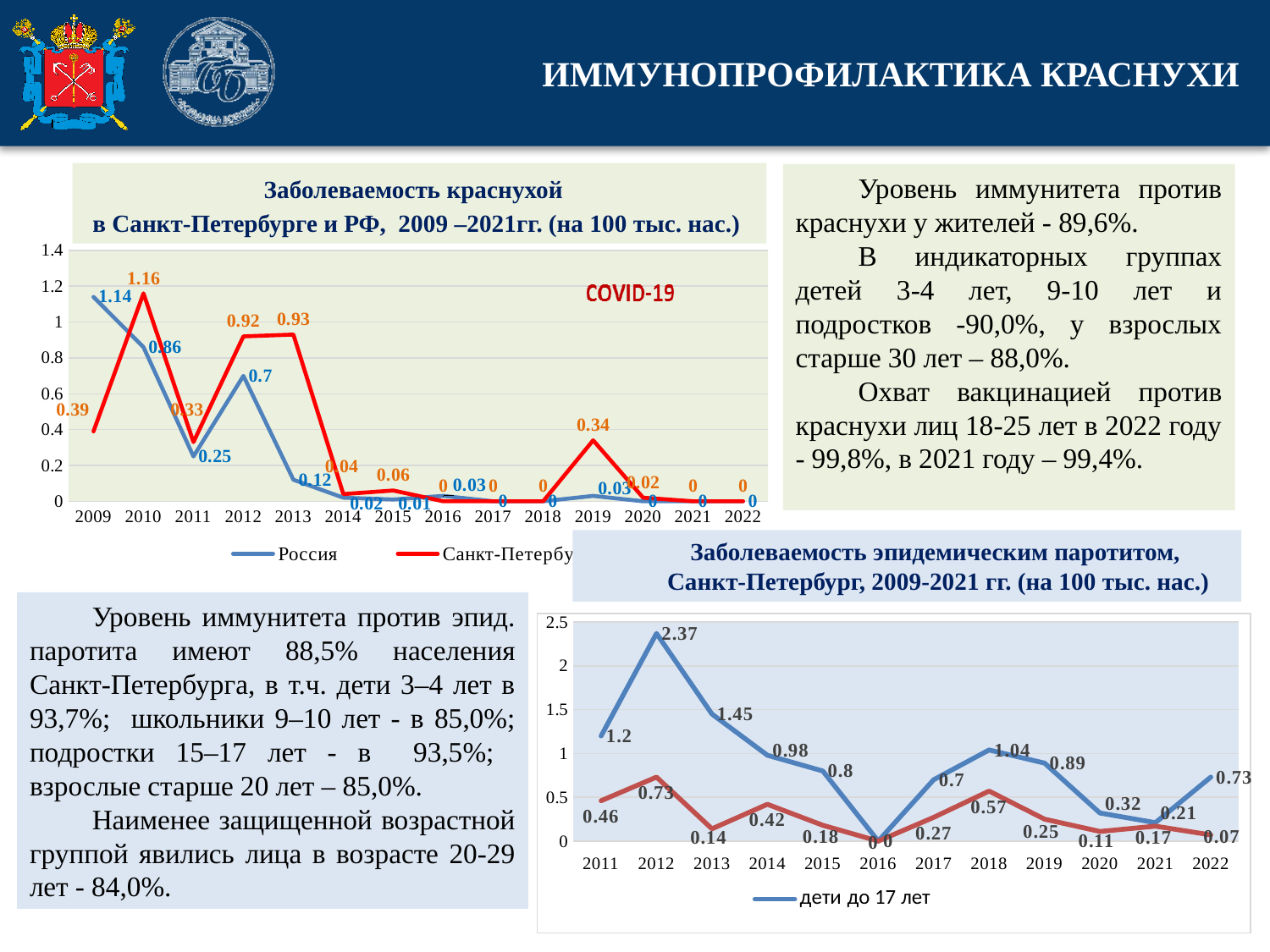
In the chart 'Заболеваемость краснухой в Санкт-Петербурге и РФ', in which year does the Санкт-Петербург series reach its highest value? 2010 In the chart 'Заболеваемость эпидемическим паротитом', how many years are shown on the x axis? 12 In the chart 'Заболеваемость эпидемическим паротитом', what is the difference between the дети до 17 лет values in 2012 and 2013? 0.92 What kind of chart is 'Заболеваемость краснухой в Санкт-Петербурге и РФ'? Line chart In the chart 'Заболеваемость краснухой в Санкт-Петербурге и РФ', how many series does the legend list? 2 In the chart 'Заболеваемость краснухой в Санкт-Петербурге и РФ', what is the value for Санкт-Петербург in 2019? 0.34 In the chart 'Заболеваемость краснухой в Санкт-Петербурге и РФ', which is larger in 2012: the value for Россия or for Санкт-Петербург? Санкт-Петербург In the chart 'Заболеваемость краснухой в Санкт-Петербурге и РФ', what is the value for Россия in 2009? 1.14 In the chart 'Заболеваемость эпидемическим паротитом', in which year does the дети до 17 лет series reach its highest value? 2012 In the chart 'Заболеваемость краснухой в Санкт-Петербурге и РФ', what is the value for Санкт-Петербург in 2010? 1.16 In the chart 'Заболеваемость эпидемическим паротитом', what is the value for дети до 17 лет in 2012? 2.37 In the chart 'Заболеваемость эпидемическим паротитом', which is larger for дети до 17 лет: the value in 2018 or in 2019? 2018